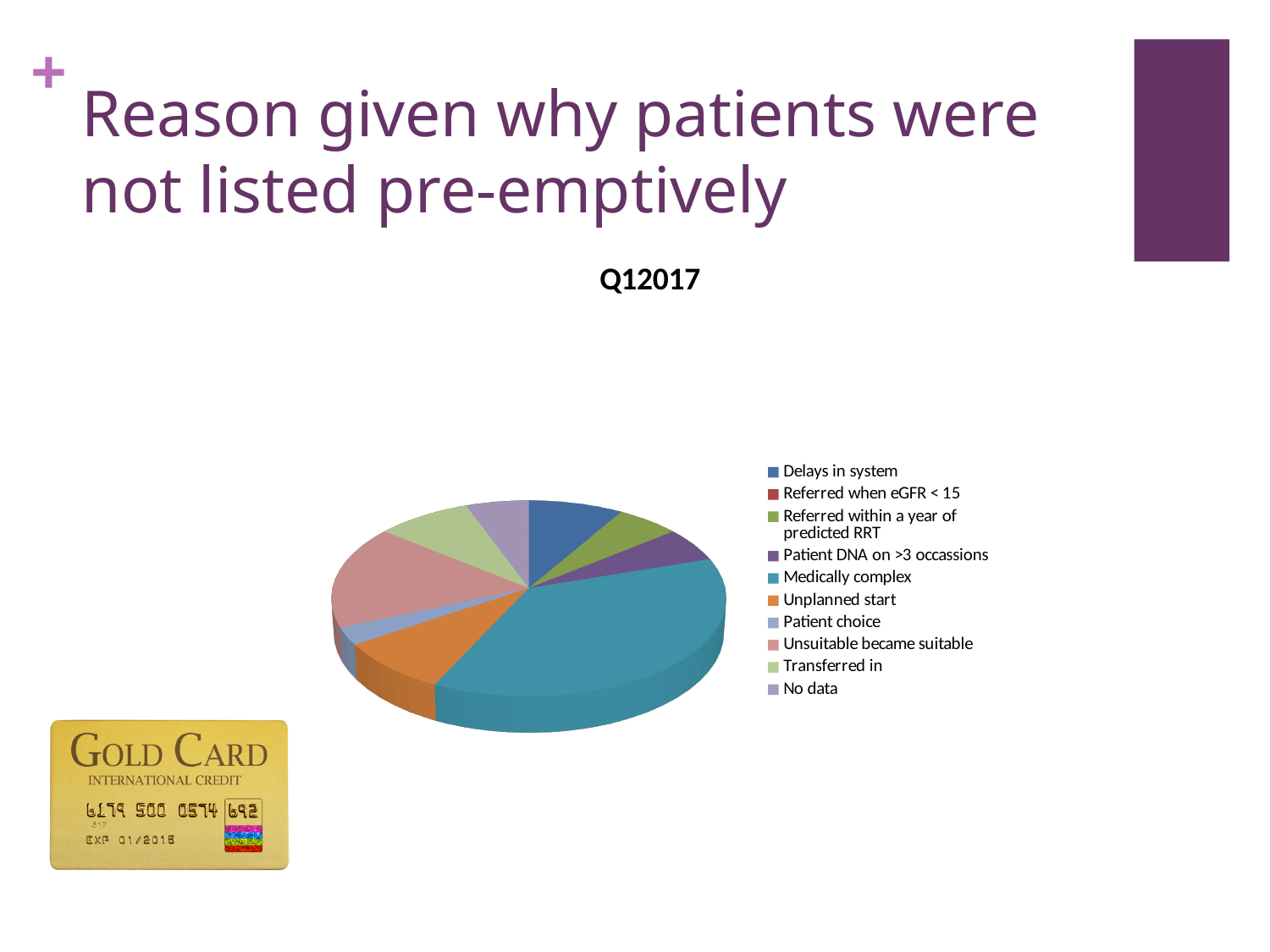
Which slice is larger, Unsuitable became suitable or Patient choice? Unsuitable became suitable What is the title of the chart? Q12017 Which slice is larger, Unplanned start or Patient choice? Unplanned start What colour is used for the Medically complex slice? teal How many entries does the chart's legend list? 10 What kind of chart is shown on the slide? pie chart Which slice is larger, Medically complex or Delays in system? Medically complex Which reason accounts for the largest slice of the pie? Medically complex